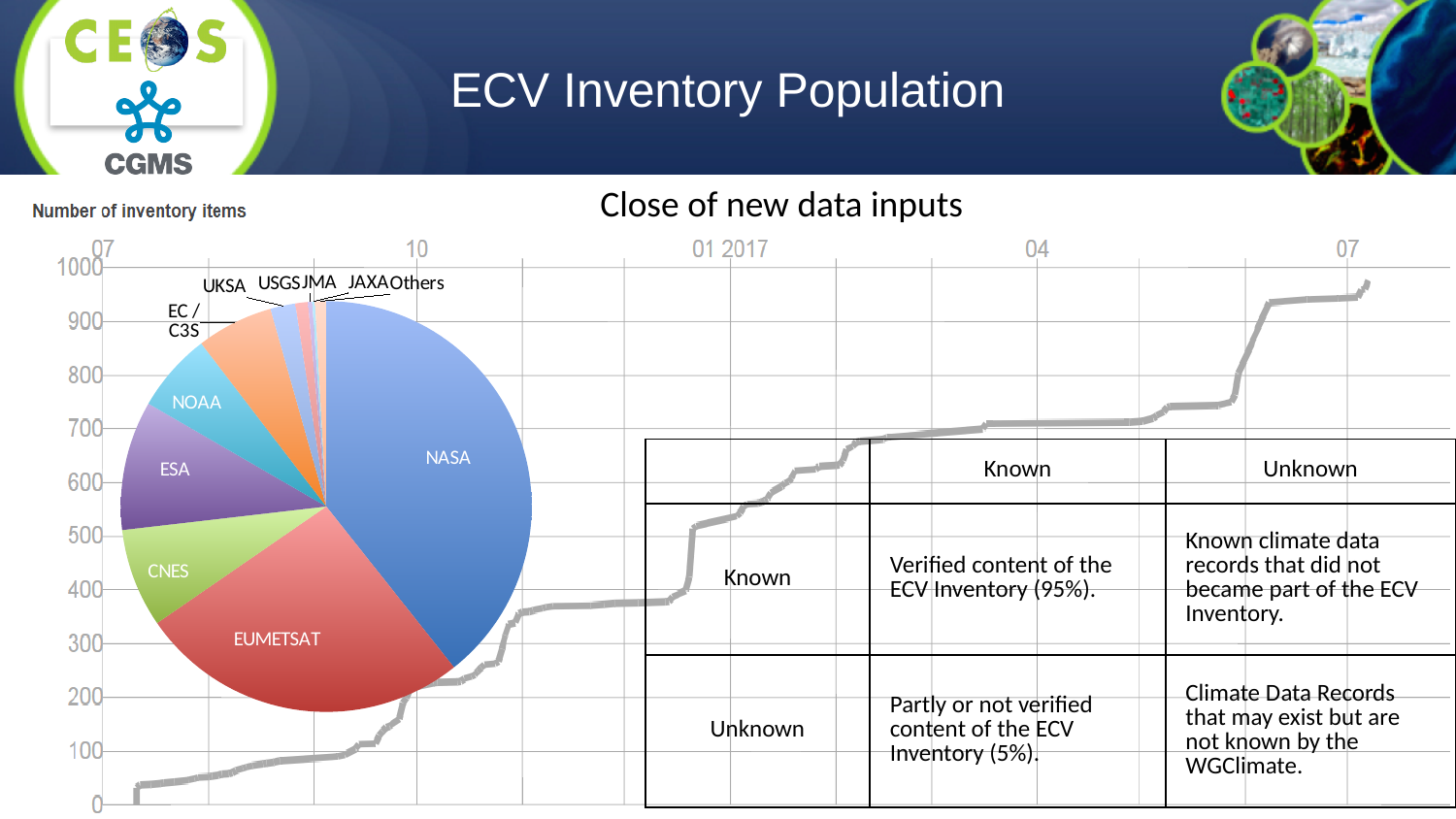
What is the title of the line chart? Number of inventory items What kind of chart is the chart showing agencies such as NASA and EUMETSAT? pie chart In the 'Number of inventory items' line chart, do the values rise or fall over time? rise In the pie chart, which slice is larger, ESA or NOAA? ESA In the pie chart, which slice is larger, EUMETSAT or CNES? EUMETSAT How many slices does the pie chart have? 11 In the 'Number of inventory items' line chart, is the value at the first 07 tick greater or less than 100? less In the 'Number of inventory items' line chart, is the value at the final 07 tick greater or less than 900? greater In the pie chart, which slice is larger, NASA or EUMETSAT? NASA In the 'Number of inventory items' line chart, is the value at the 10 tick greater or less than 100? greater In the pie chart, which agency has the largest slice? NASA What kind of chart is the 'Number of inventory items' chart? line chart